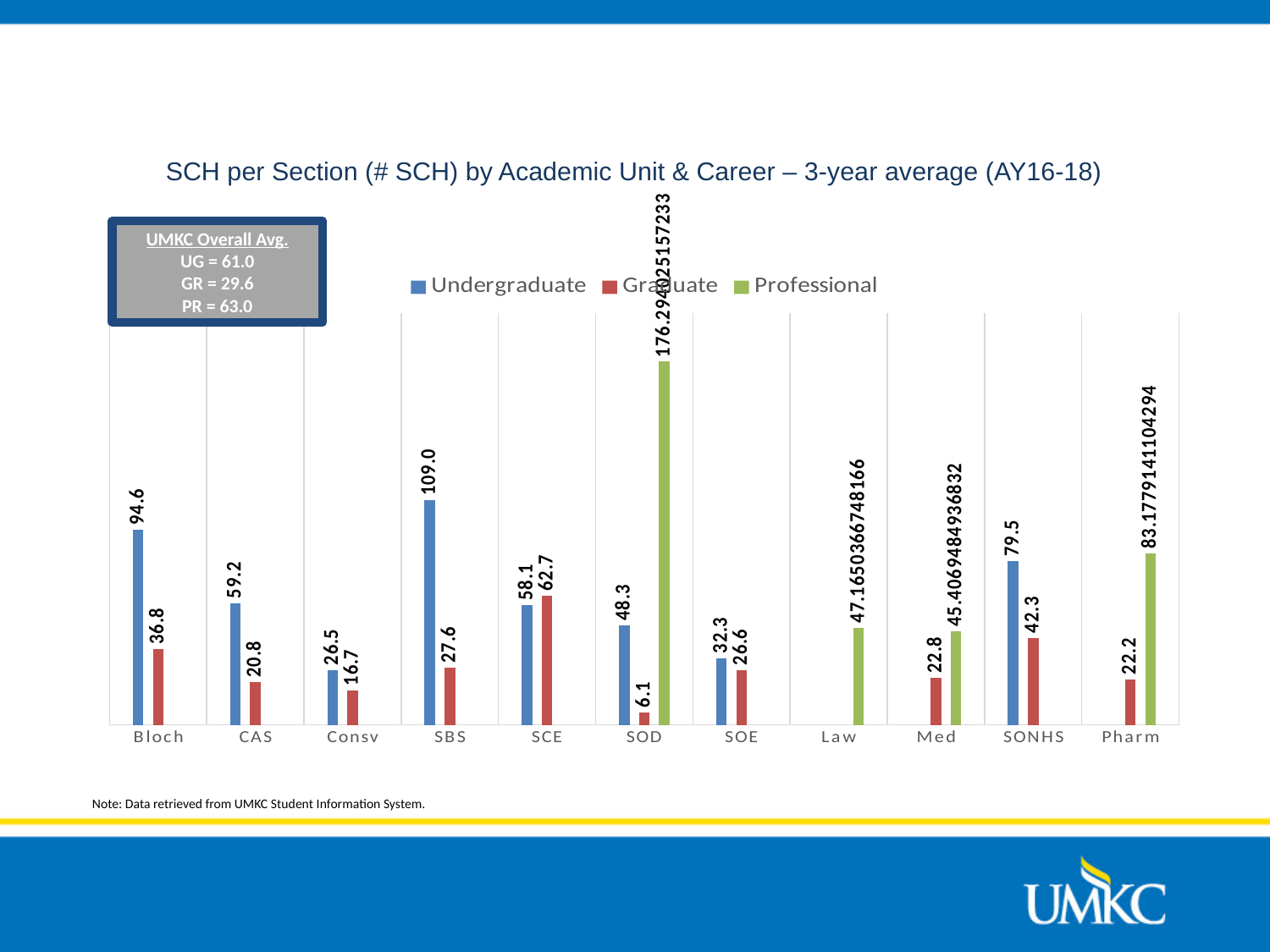
What is the Undergraduate value for SBS? 109.0 How many series does the legend list? 3 How many academic units are shown on the x axis? 11 Which is larger for SCE, the Undergraduate value or the Graduate value? Graduate What is the Graduate value for Pharm? 22.2 What is the Graduate value for SOD? 6.1 Which academic unit has the highest Undergraduate value? SBS What is the difference between the Undergraduate and Graduate values for Bloch? 57.8 According to the box on the slide, what is the UMKC overall average for UG? 61.0 What is the Professional value for Law? 47.1650366748166 What kind of chart is shown on the slide? Bar chart Which academic unit has the lowest Graduate value? SOD